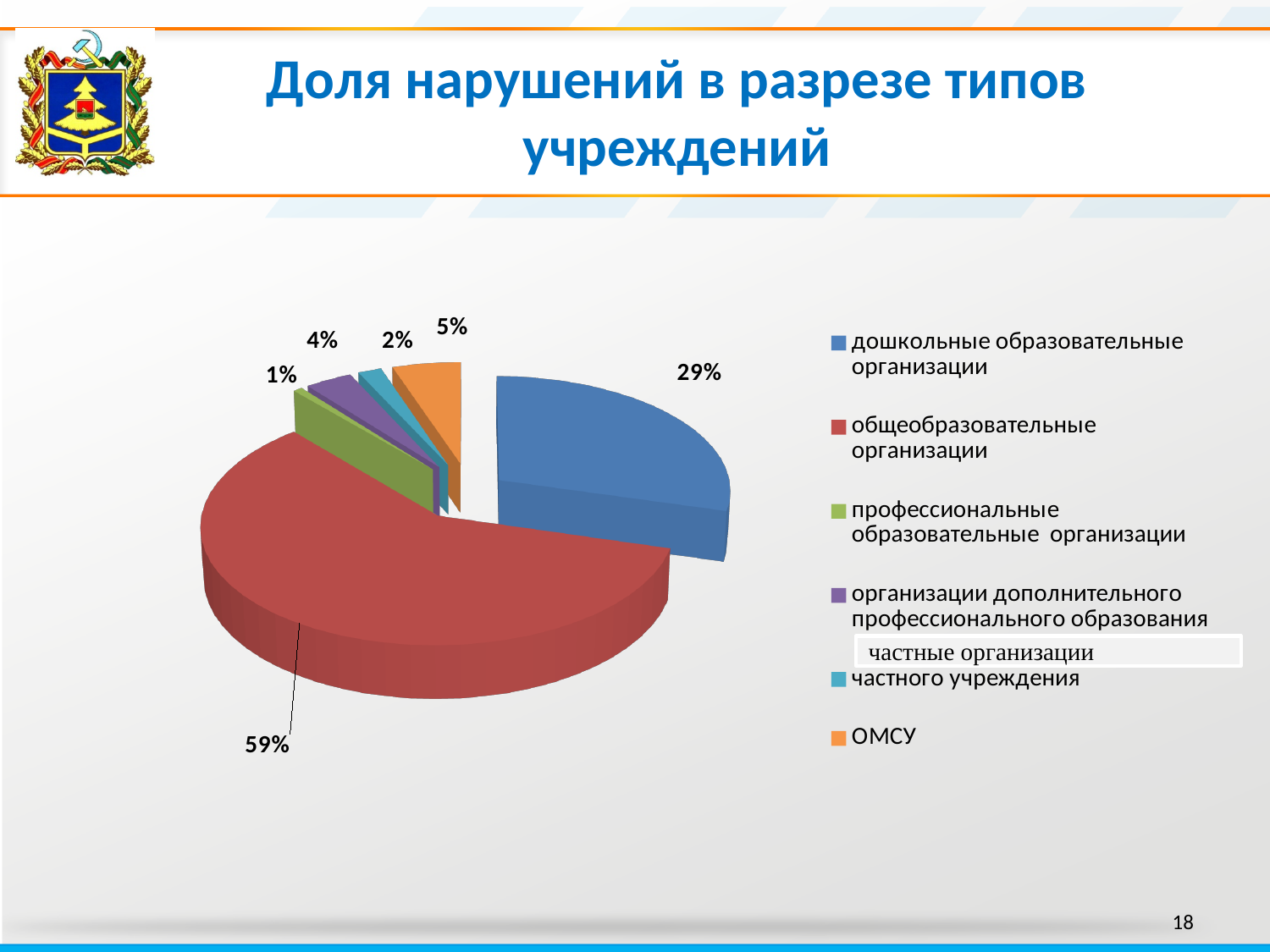
What share of violations is attributed to ОМСУ? 5% Which category has the smallest share of violations? профессиональные образовательные организации What share of violations is attributed to организации дополнительного профессионального образования? 4% What colour is the slice for общеобразовательные организации? red Which has a larger share: ОМСУ or организации дополнительного профессионального образования? ОМСУ Which category has the largest share of violations? общеобразовательные организации What share of violations is attributed to профессиональные образовательные организации? 1% How many categories does the legend list? 6 What is the difference in percentage points between общеобразовательные организации and дошкольные образовательные организации? 30 What share of violations is attributed to дошкольные образовательные организации? 29% What share of violations is attributed to общеобразовательные организации? 59% What type of chart is shown on the slide? pie chart